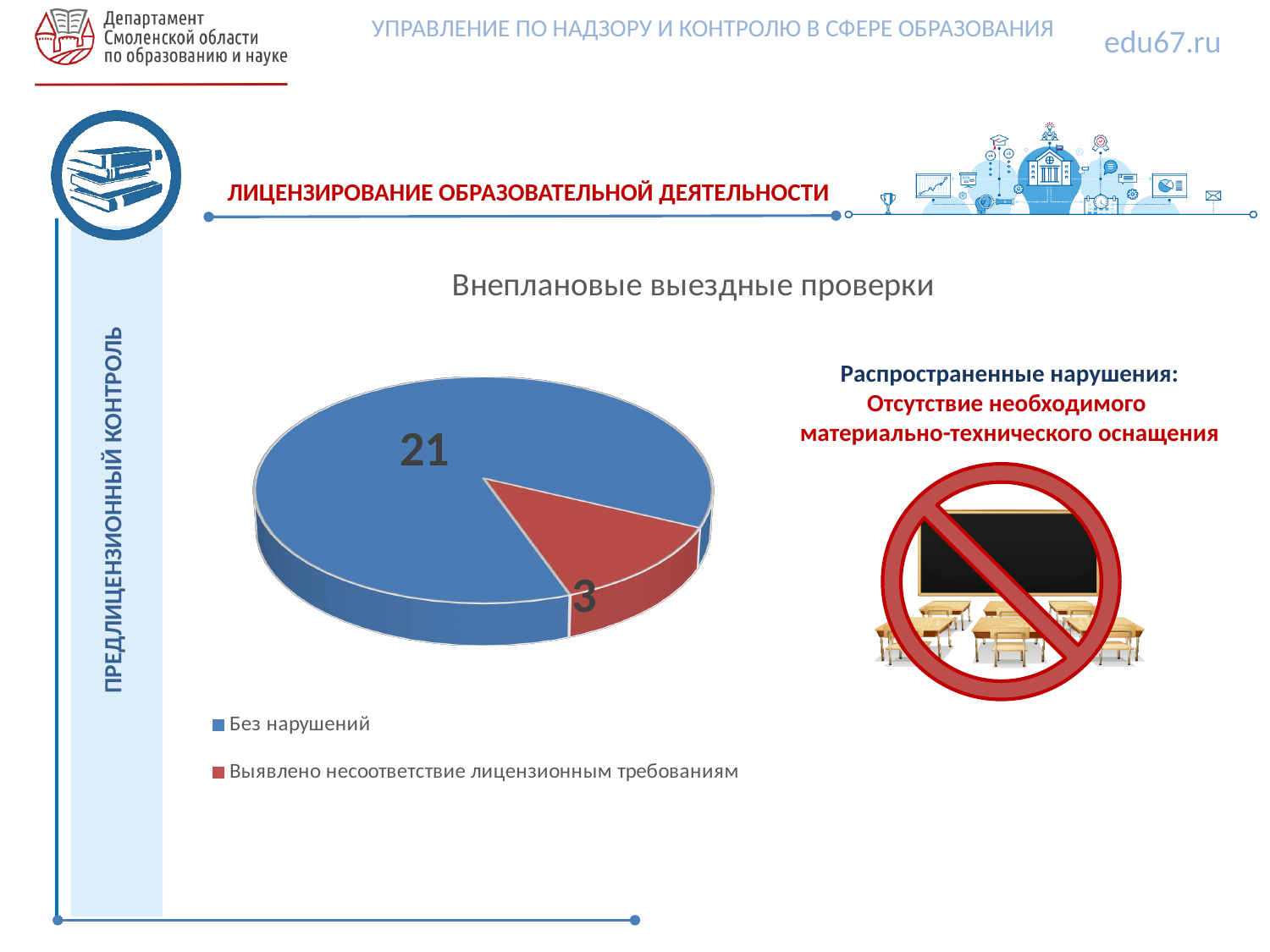
What is the title of the chart? Внеплановые выездные проверки What is the difference between the value for "Без нарушений" and the value for "Выявлено несоответствие лицензионным требованиям"? 18 What is the value for "Без нарушений"? 21 Which category has the smallest slice of the pie? Выявлено несоответствие лицензионным требованиям Which category has the largest slice of the pie? Без нарушений What is the value for "Выявлено несоответствие лицензионным требованиям"? 3 What type of chart is shown on the slide? Pie chart Which is larger: the value for "Без нарушений" or the value for "Выявлено несоответствие лицензионным требованиям"? Без нарушений What share of the pie does "Выявлено несоответствие лицензионным требованиям" represent? 12.5% How many slices does the pie chart have? 2 How many entries does the legend list? 2 What is the total of all slices in the pie chart? 24